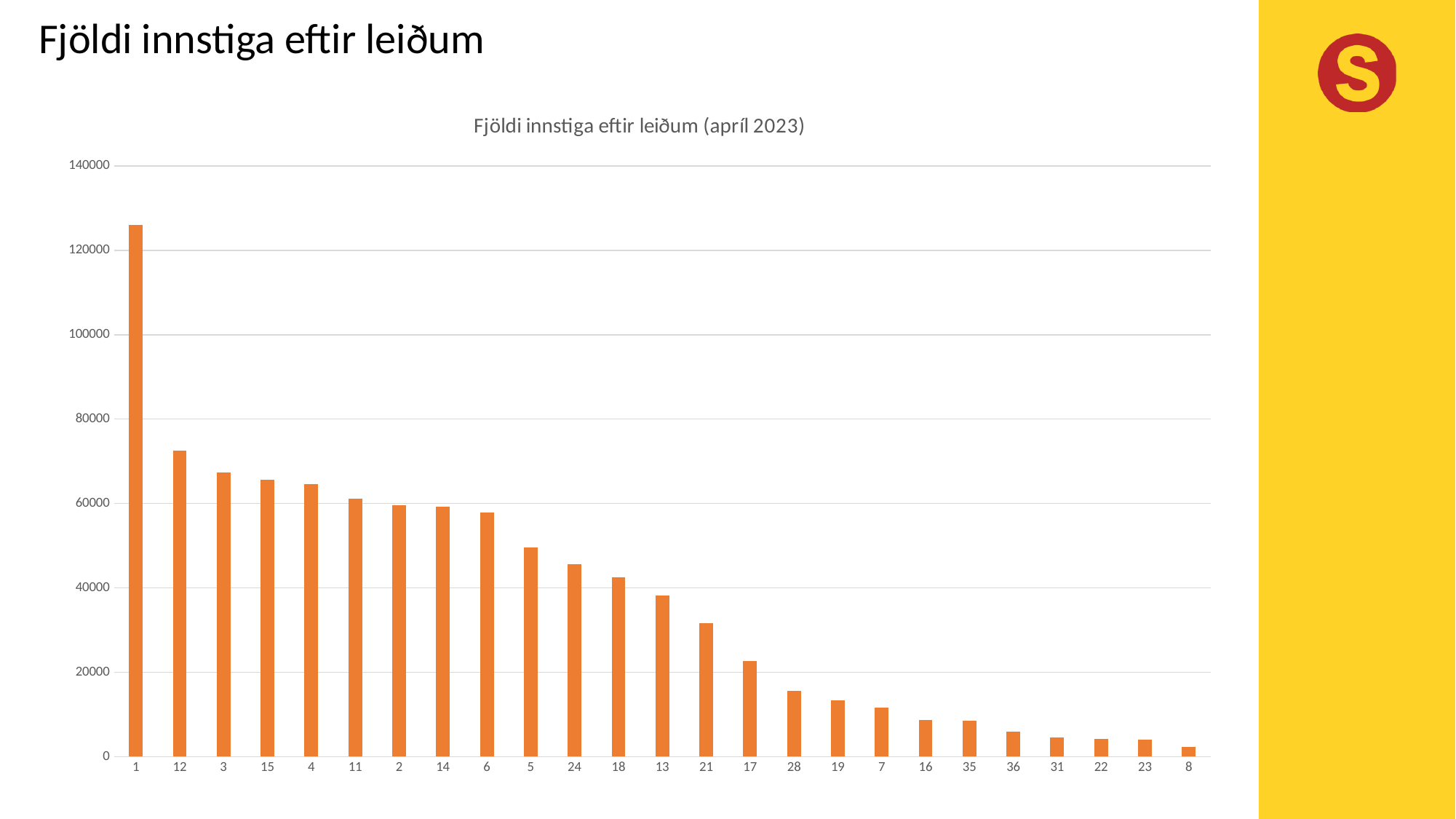
Is the value for route 1 greater or less than 120000? greater Is the value for route 12 greater or less than 80000? less Which route (category) has the lowest number of boardings? 8 What is the title of the chart? Fjöldi innstiga eftir leiðum (apríl 2023) Is the value for route 28 greater or less than 20000? less Which route (category) has the highest number of boardings? 1 Which has the larger value, route 12 or route 3? 12 What kind of chart is shown on the slide? Bar chart Do the values rise or fall moving from left to right along the x axis? Fall How many routes (categories) are plotted on the x axis? 25